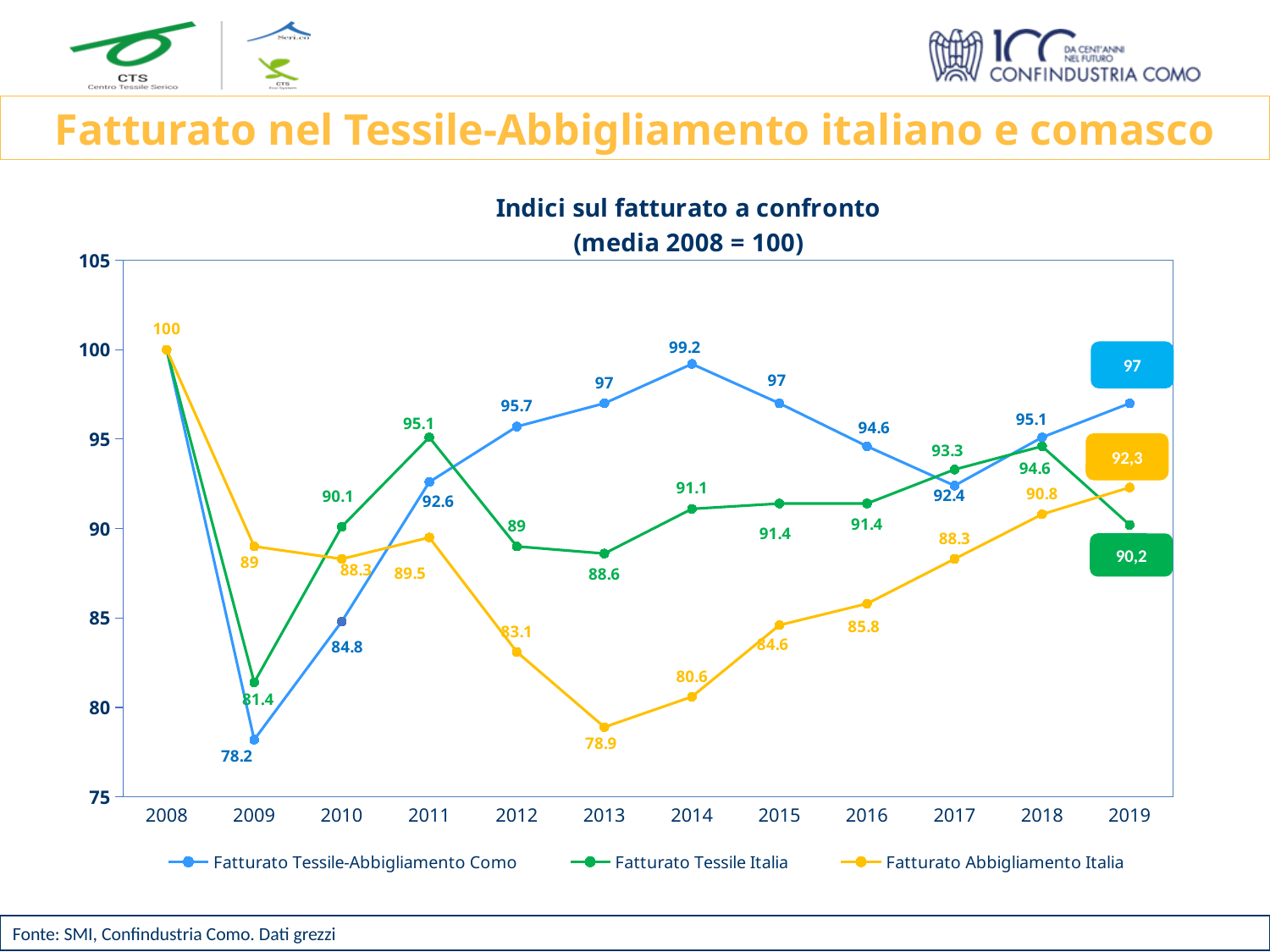
What is the difference between Fatturato Tessile-Abbigliamento Como and Fatturato Abbigliamento Italia in 2013? 18.1 How many years are plotted on the x axis? 12 How many series does the legend list? 3 What is the value of Fatturato Abbigliamento Italia in 2013? 78.9 What is the subtitle of the chart shown in parentheses under 'Indici sul fatturato a confronto'? (media 2008 = 100) Does Fatturato Abbigliamento Italia rise or fall between 2013 and 2019? rise What is the value of Fatturato Tessile-Abbigliamento Como in 2014? 99.2 In 2012, which is larger: Fatturato Tessile Italia or Fatturato Abbigliamento Italia? Fatturato Tessile Italia What type of chart is shown on the slide? line chart Excluding 2008, in which year does Fatturato Tessile-Abbigliamento Como reach its highest value? 2014 In which year does Fatturato Tessile-Abbigliamento Como reach its lowest value? 2009 What is the value of Fatturato Tessile Italia in 2011? 95.1